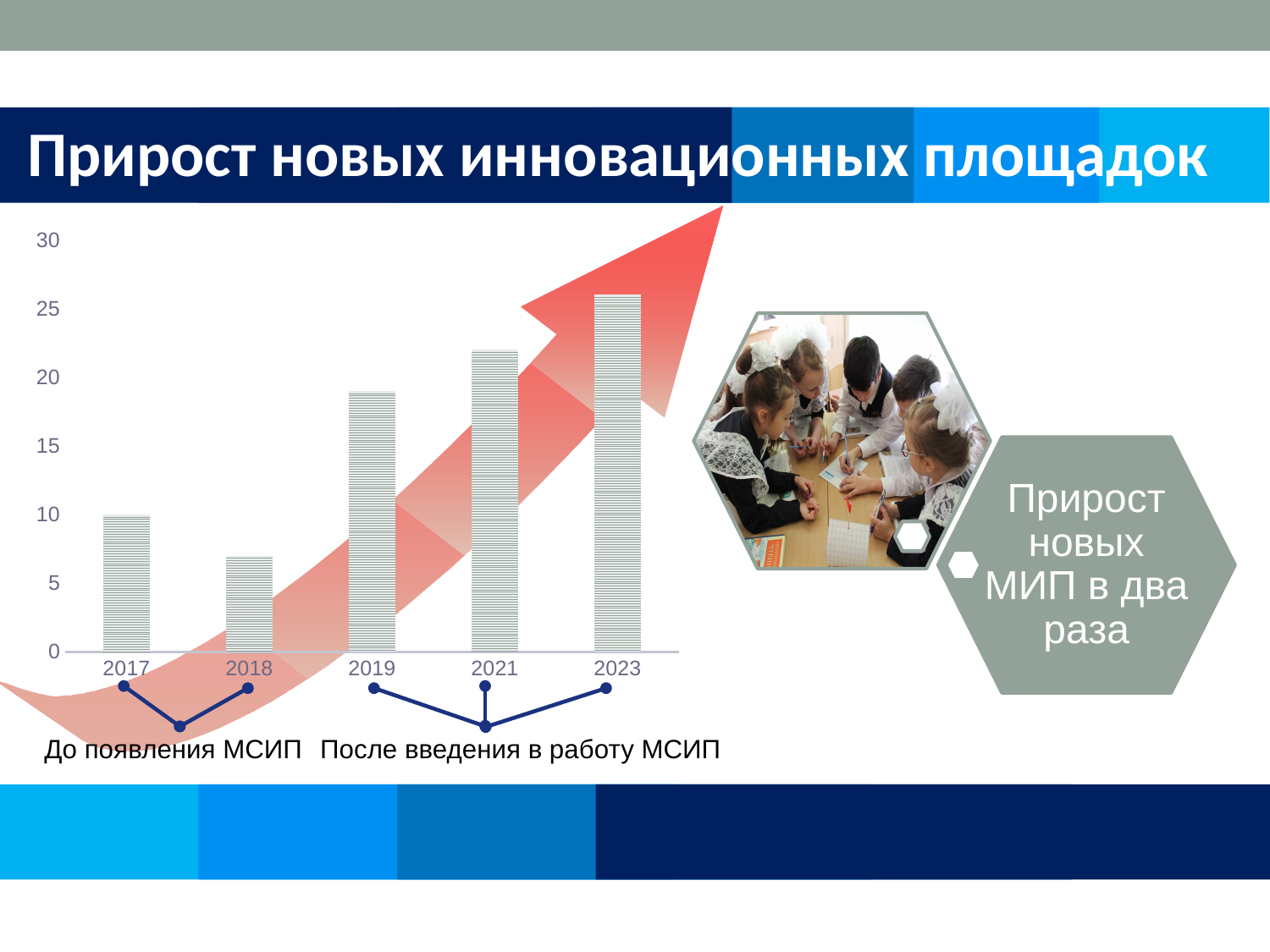
Is the value for 2021 greater or less than 20? greater Which year has the lowest bar in the chart? 2018 Is the value for 2018 greater or less than 10? less Do the values rise or fall from 2018 to 2023 along the x axis? rise What is the title of the slide above the chart? Прирост новых инновационных площадок Which year has the highest bar in the chart? 2023 Is the value for 2019 greater or less than 15? greater What kind of chart is shown on the slide? bar chart How many years (categories) are plotted on the x axis of the chart? 5 What is the value for 2017 in the chart? 10 Which is larger, the value for 2019 or the value for 2018? 2019